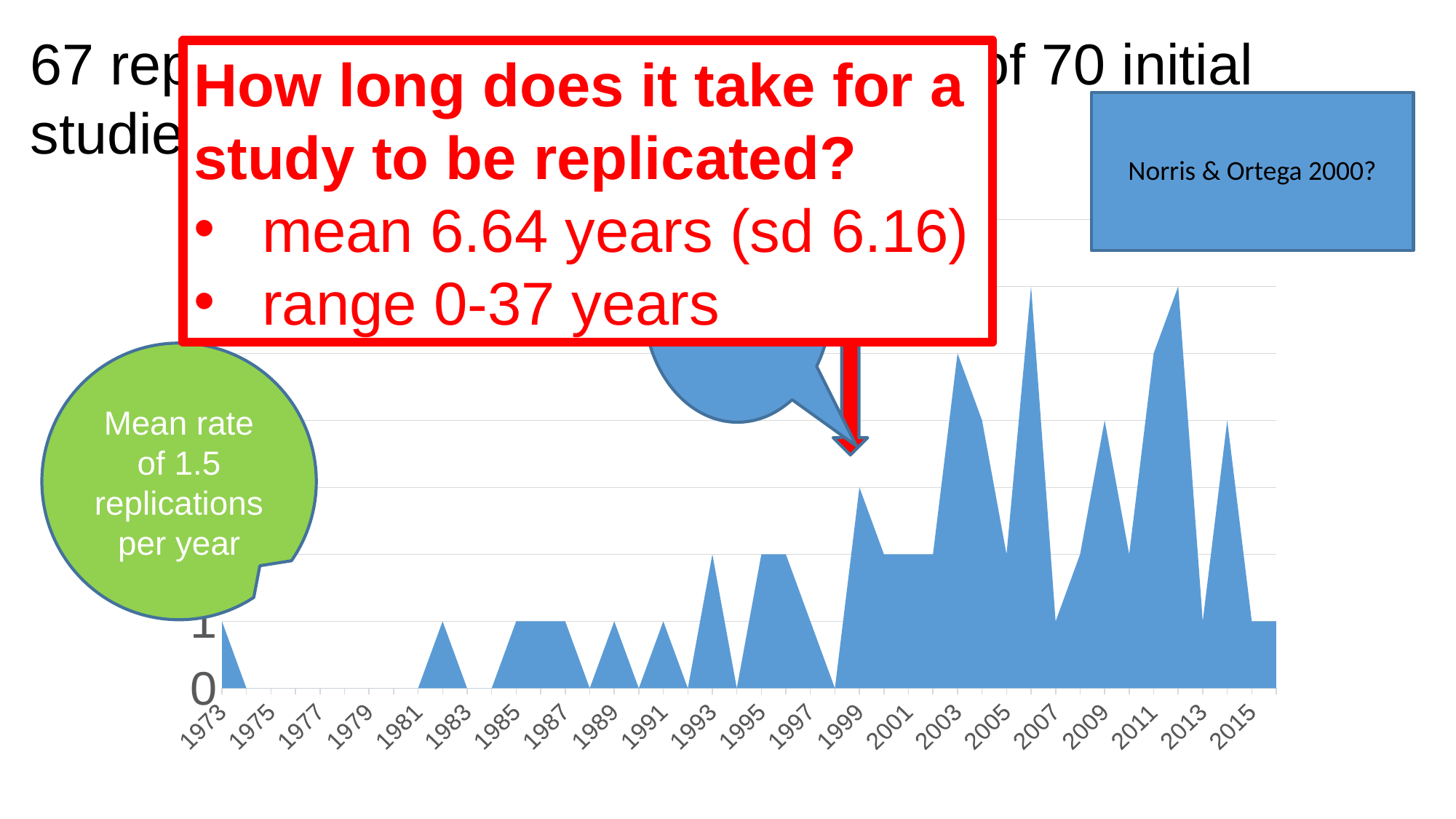
Do the plotted values generally rise or fall from the 1970s to the 2010s? rise What kind of chart is shown on the slide? area chart Is the value for 1999 greater or less than 1? greater What is the value plotted for 2007? 1 What is the value plotted for 1977? 0 Which year has the larger value, 2006 or 2007? 2006 What is the first year labelled on the x axis? 1973 Which year has the larger value, 1993 or 1991? 1993 Which year has the larger value, 1999 or 1995? 1999 What is the value plotted for 1998? 0 Is the value for 2003 greater or less than 1? greater What is the value plotted for 1973? 1